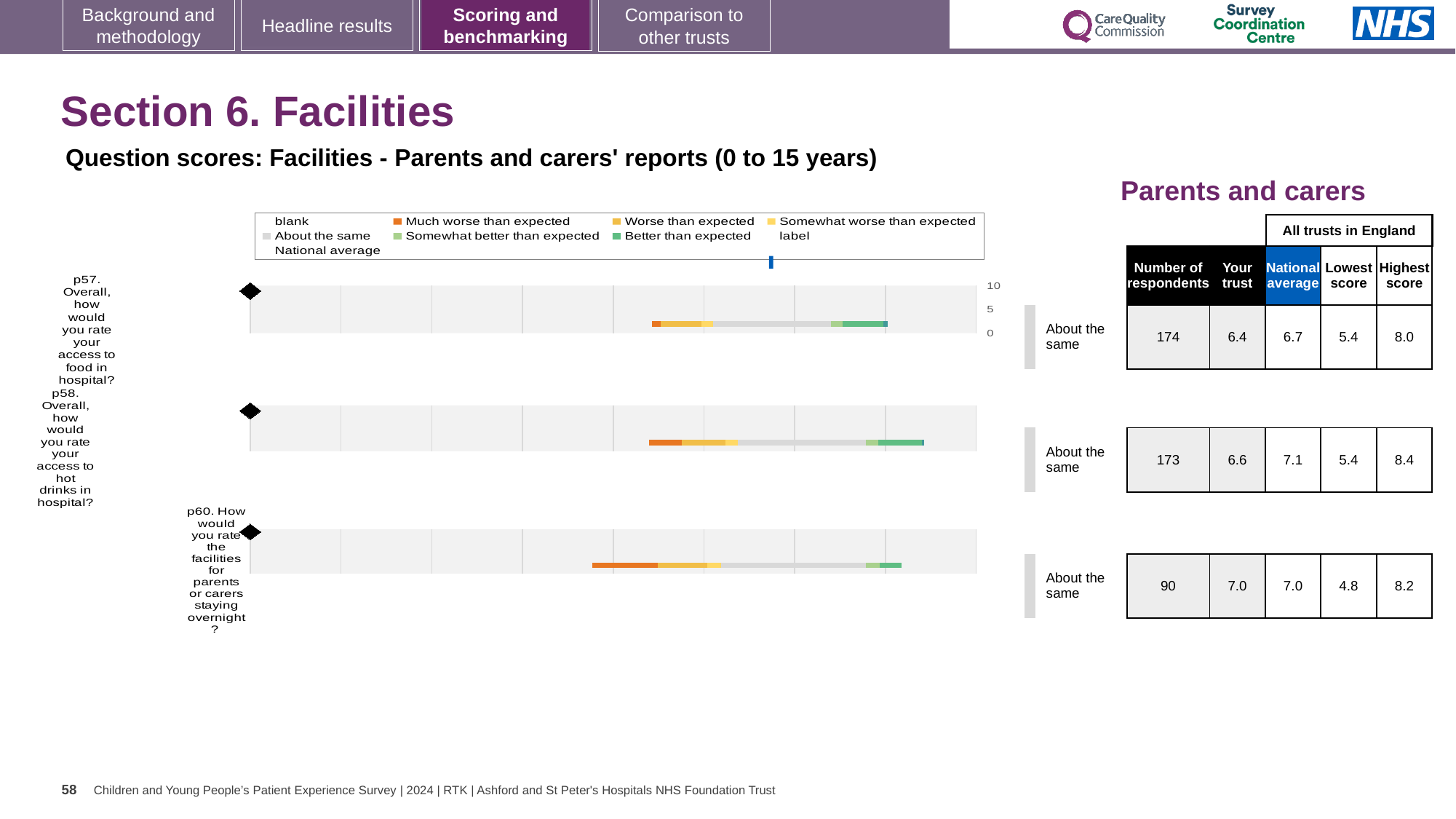
Which question has the highest 'Highest score' among all trusts in England? p58 How many questions (categories) are plotted in the Facilities question scores chart? 3 What is the Highest score across all trusts in England for p60? 8.2 What colour represents 'Much worse than expected' in the chart legend? orange Which question has the most respondents? p57 What is the 'Your trust' score for p57 (access to food in hospital)? 6.4 What is the difference between the Highest score and the Lowest score for p58? 3.0 What kind of chart is used to show the question scores for Facilities? bar chart For p57, which is larger: the 'Your trust' score or the National average? National average How many respondents answered p60 (facilities for parents or carers staying overnight)? 90 What is the National average score for p58 (access to hot drinks in hospital)? 7.1 Which question has the lowest 'Lowest score' among all trusts in England? p60